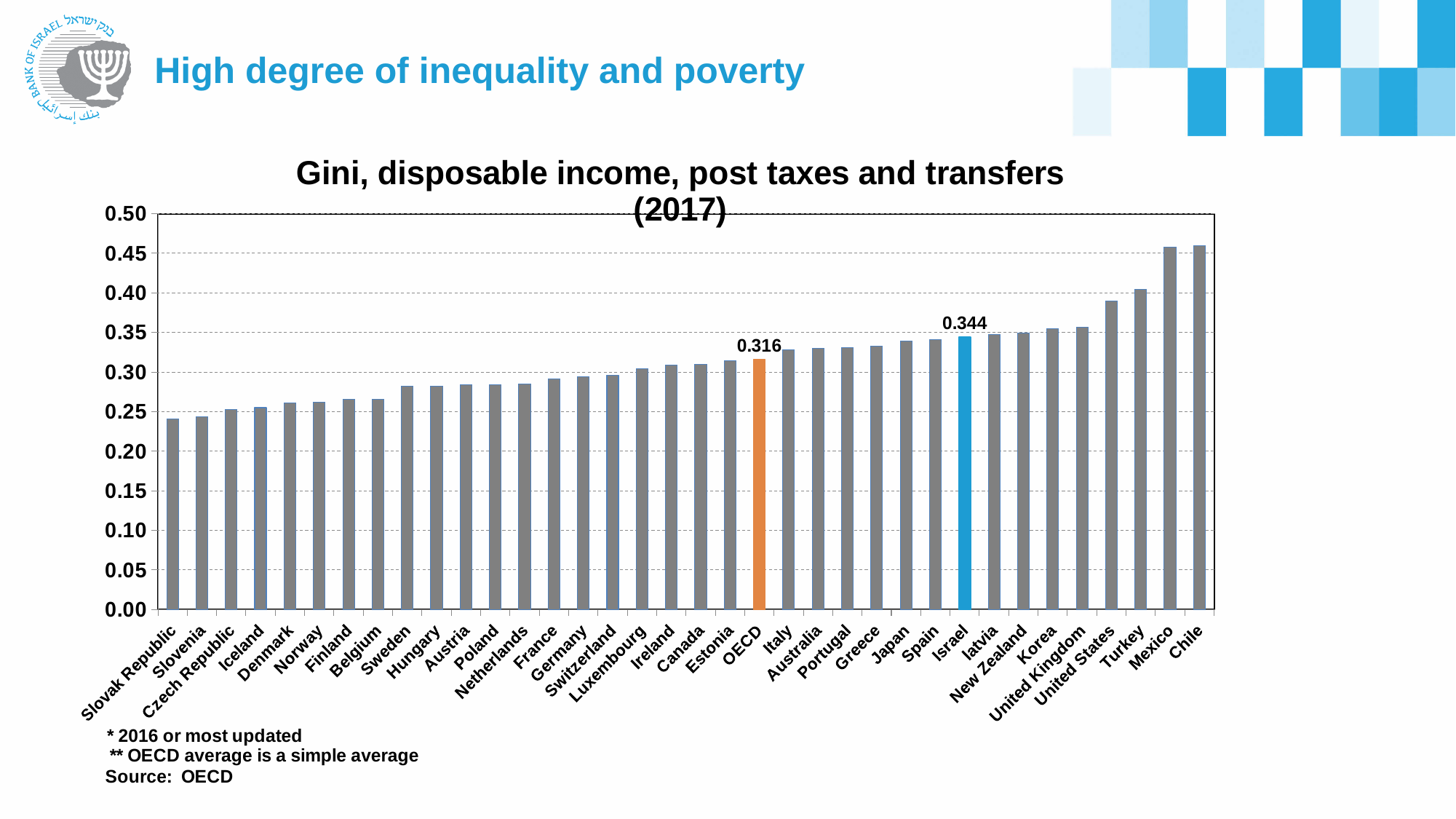
Is the value for the United States greater or less than 0.35? greater What is the Gini value shown for the OECD average? 0.316 What is the difference between the Gini values for Israel and the OECD average? 0.028 Which has the higher Gini value, Israel or the OECD average? Israel How many bars are plotted in the chart? 36 Is the value for Germany greater or less than 0.30? less Is the value for Denmark greater or less than 0.30? less What is the Gini value shown for Israel? 0.344 Do the values generally rise or fall from left to right across the chart? Rise Which has the higher Gini value, the United States or Italy? United States What kind of chart is shown on the slide? Bar chart